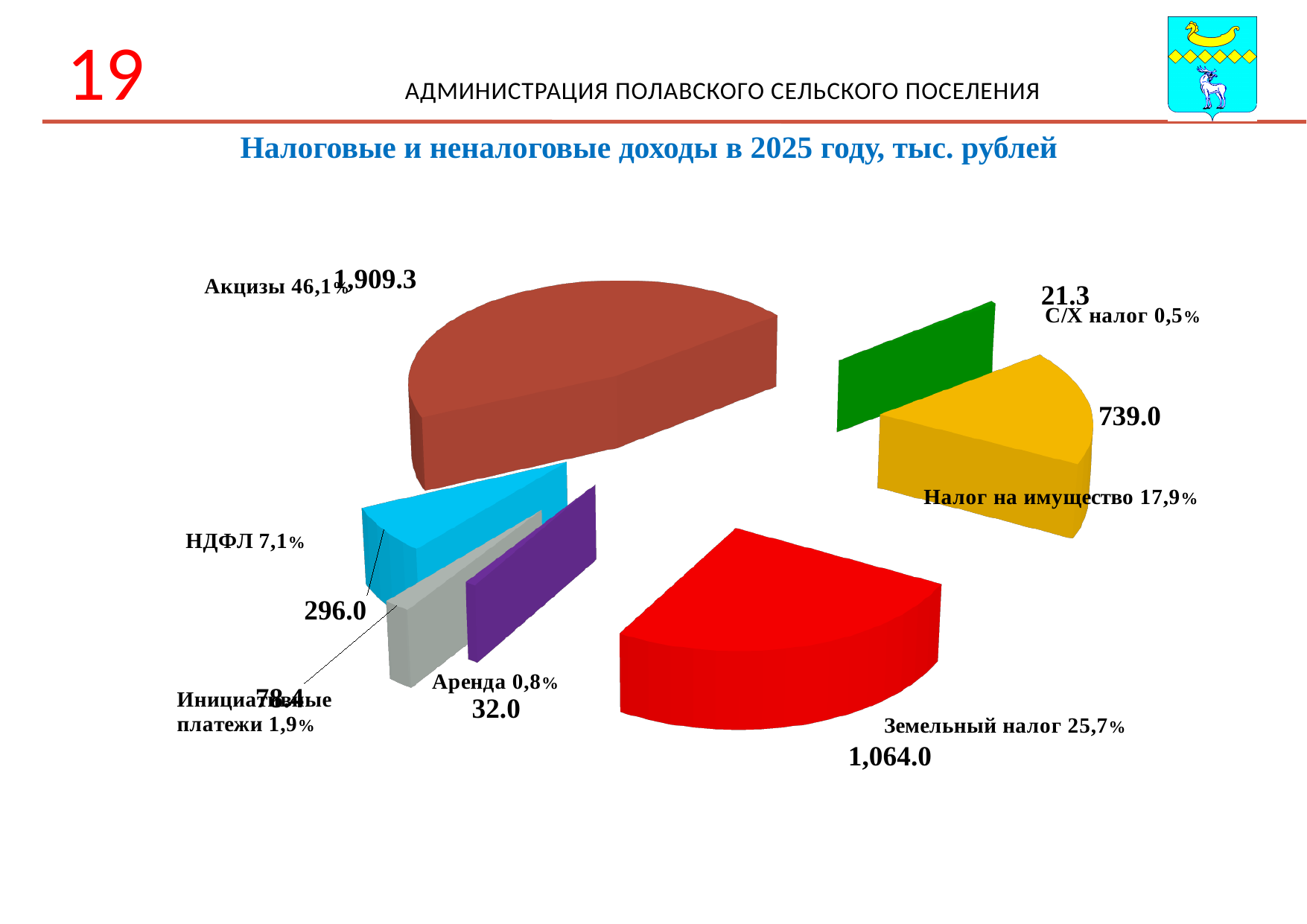
What is the value for Земельный налог? 1,064.0 What is the difference between the values for Земельный налог and Налог на имущество? 325.0 What is the value for С/Х налог? 21.3 What kind of chart is shown on the slide? pie chart Which category has the largest slice of the pie? Акцизы Which category has the smallest slice of the pie? С/Х налог What is the value for Налог на имущество? 739.0 What is the value for Акцизы? 1,909.3 What is the value for НДФЛ? 296.0 What share of the pie does Земельный налог represent? 25,7% How many slices does the pie chart have? 7 What is the value for Аренда? 32.0